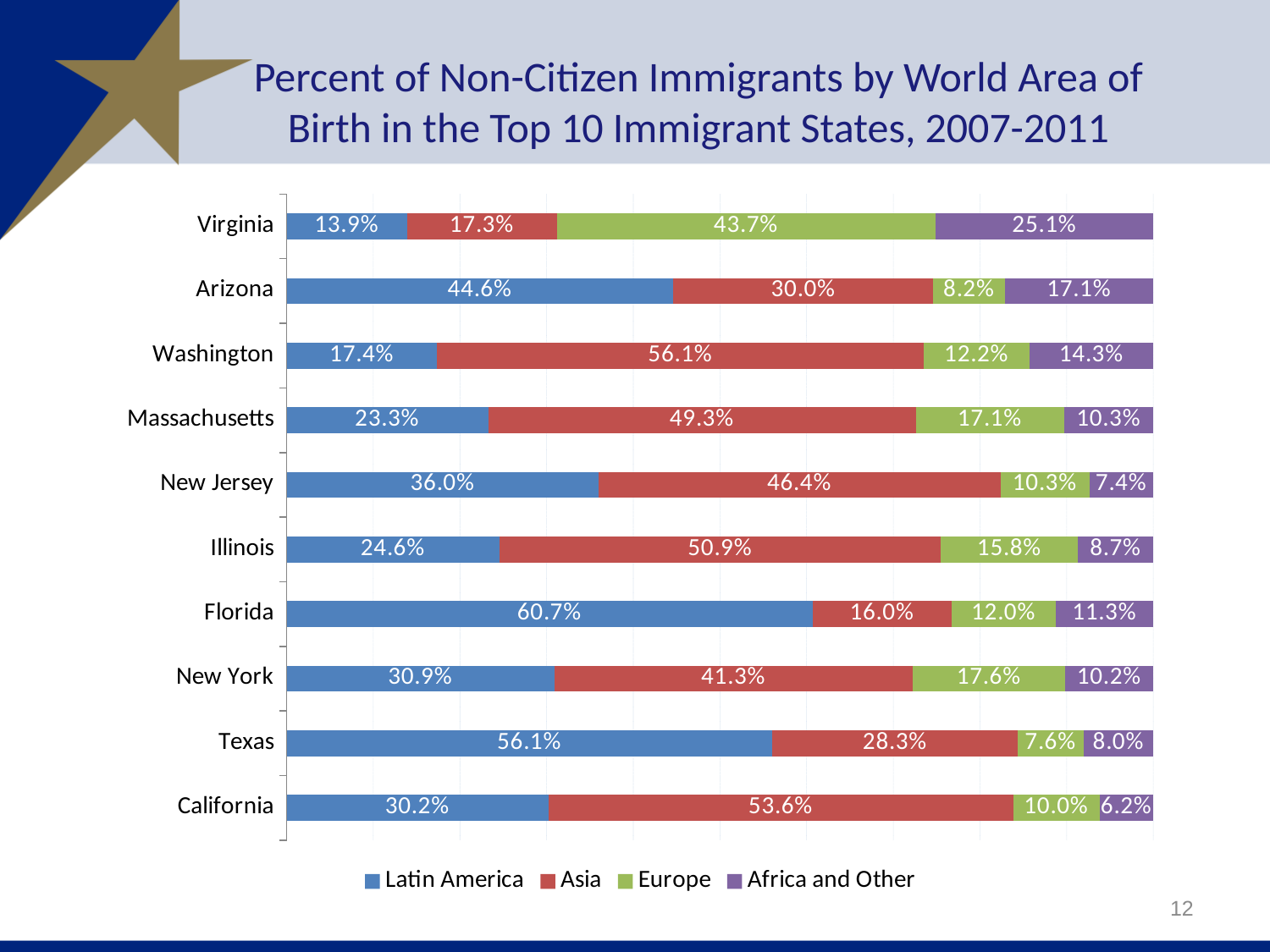
What is the Asia value for Washington? 56.1% How many states are shown on the chart? 10 Which state has the highest Latin America value? Florida What is the difference between the Asia values for California and Texas? 25.3% What is the Latin America value for Florida? 60.7% Which is larger, the Latin America value for Arizona or for New Jersey? Arizona How many series does the legend list? 4 Which series is shown in green in the legend? Europe What kind of chart is shown on the slide? Stacked bar chart What is the Europe value for Virginia? 43.7% Which state has the lowest Asia value? Florida What is the Africa and Other value for California? 6.2%